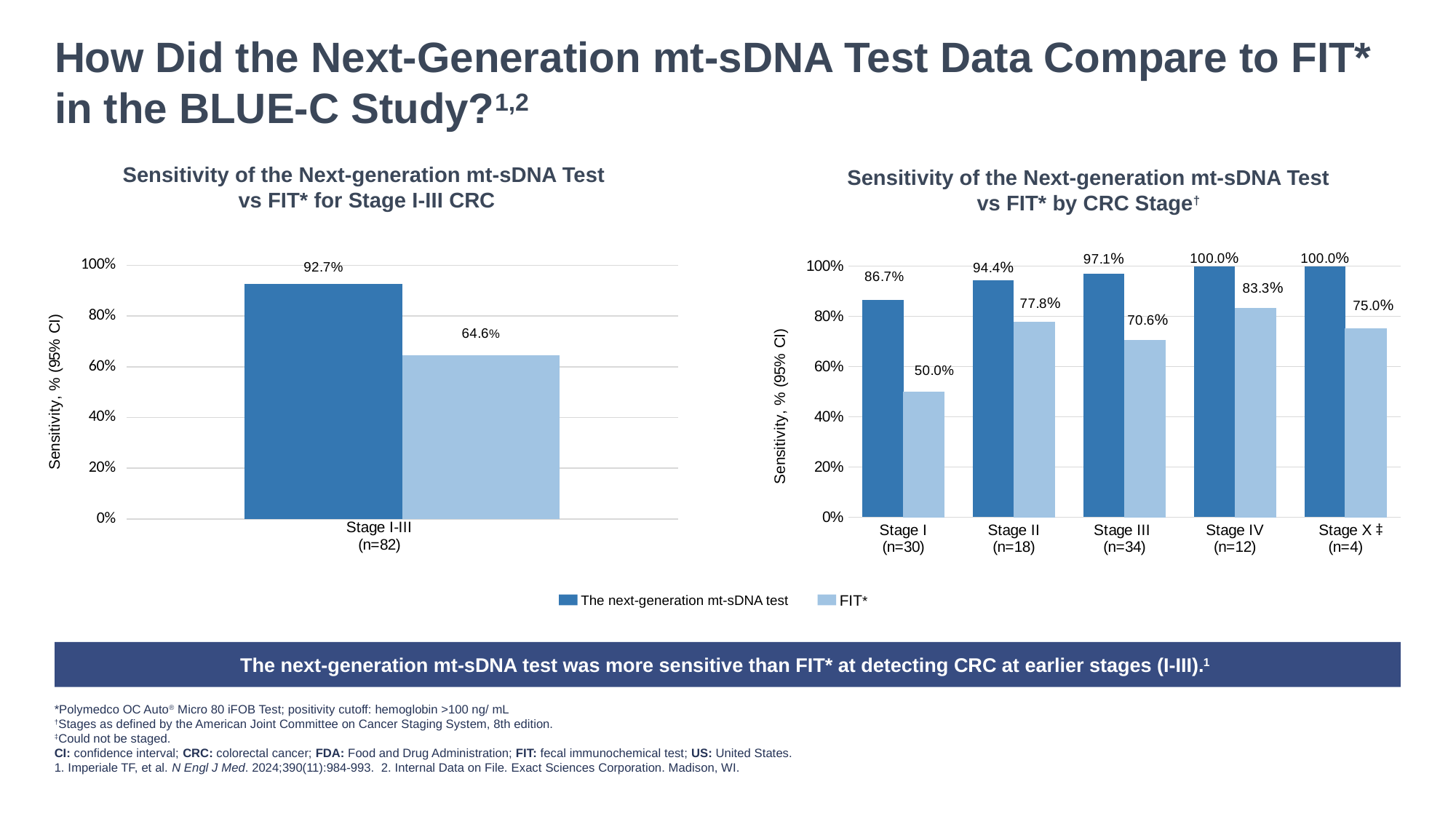
In the right chart (by CRC Stage), what is the next-generation mt-sDNA test sensitivity for Stage III? 97.1% How many series does the legend list? 2 In the left chart (Stage I-III CRC), what is the difference between the next-generation mt-sDNA test and FIT* sensitivity? 28.1% What type of chart is the right chart (by CRC Stage)? Bar chart In the right chart (by CRC Stage), what is the difference between the next-generation mt-sDNA test and FIT* sensitivity for Stage II? 16.6% In the right chart (by CRC Stage), what is the FIT* sensitivity for Stage I? 50.0% In the left chart (Stage I-III CRC), what is the sensitivity of the next-generation mt-sDNA test? 92.7% In the right chart (by CRC Stage), which stage has the lowest FIT* sensitivity? Stage I How many stage categories are shown in the right chart (by CRC Stage)? 5 In the left chart (Stage I-III CRC), what is the sensitivity of FIT*? 64.6% In the right chart (by CRC Stage), which stage has the highest FIT* sensitivity? Stage IV In the right chart (by CRC Stage), is the FIT* sensitivity for Stage III greater or less than the next-generation mt-sDNA test sensitivity for Stage I? less